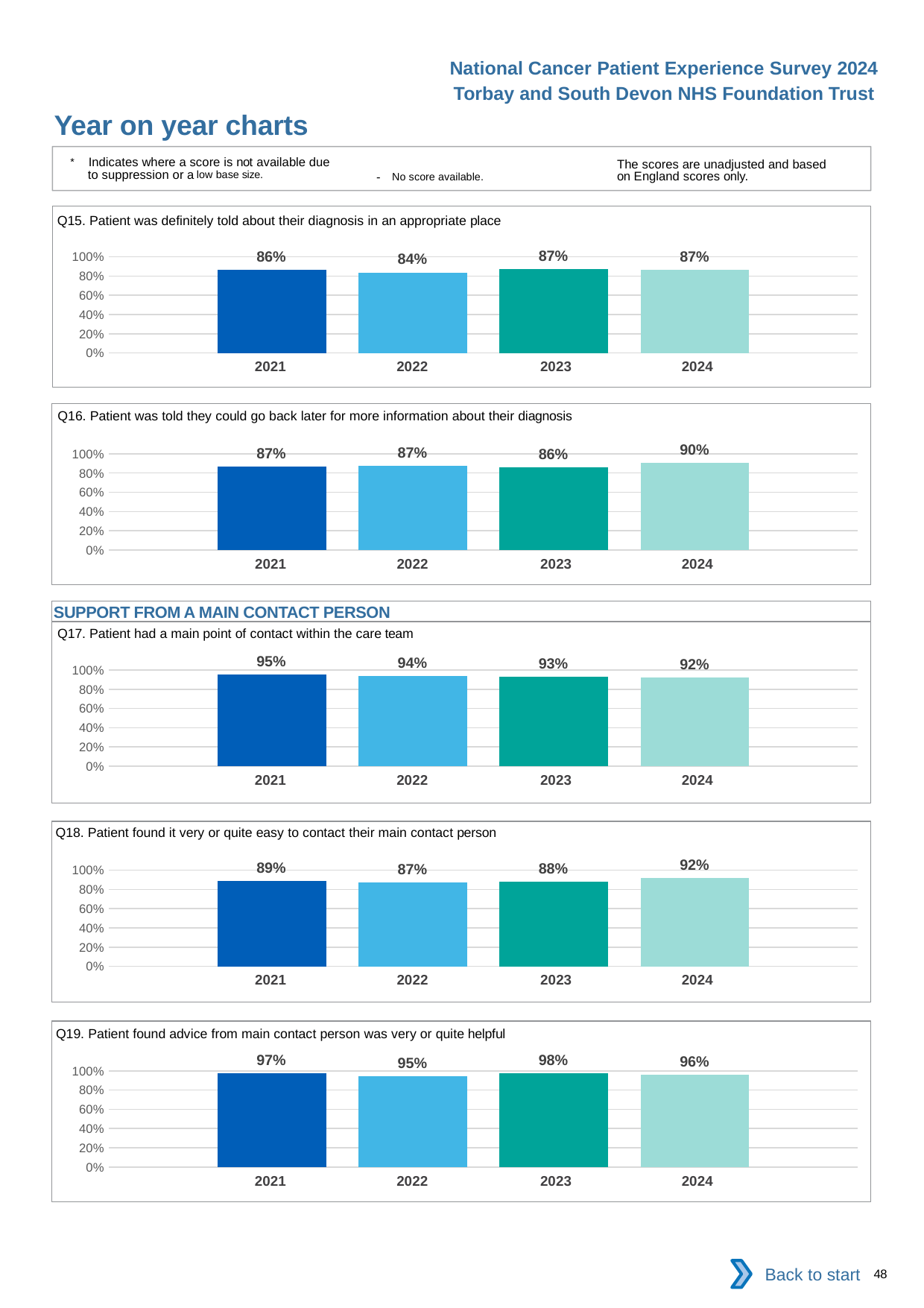
In the Q15 chart (Patient was definitely told about their diagnosis in an appropriate place), what is the value for 2022? 84% In the Q17 chart (Patient had a main point of contact within the care team), do the values rise or fall from 2021 to 2024? fall In the Q16 chart (Patient was told they could go back later for more information about their diagnosis), what is the difference between the 2024 and 2023 values? 4 percentage points What is the section heading shown above the Q17 chart? SUPPORT FROM A MAIN CONTACT PERSON What kind of chart is the Q19 chart (Patient found advice from main contact person was very or quite helpful)? bar chart In the Q18 chart (Patient found it very or quite easy to contact their main contact person), what is the value for 2024? 92% In the Q19 chart (Patient found advice from main contact person was very or quite helpful), which year has the highest value? 2023 In the Q16 chart (Patient was told they could go back later for more information about their diagnosis), which year has the highest value? 2024 In the Q19 chart (Patient found advice from main contact person was very or quite helpful), which is larger, the 2022 value or the 2024 value? 2024 In the Q18 chart (Patient found it very or quite easy to contact their main contact person), which year has the lowest value? 2022 In the Q17 chart (Patient had a main point of contact within the care team), what is the difference between the 2021 and 2024 values? 3 percentage points How many years are shown in the Q15 chart (Patient was definitely told about their diagnosis in an appropriate place)? 4